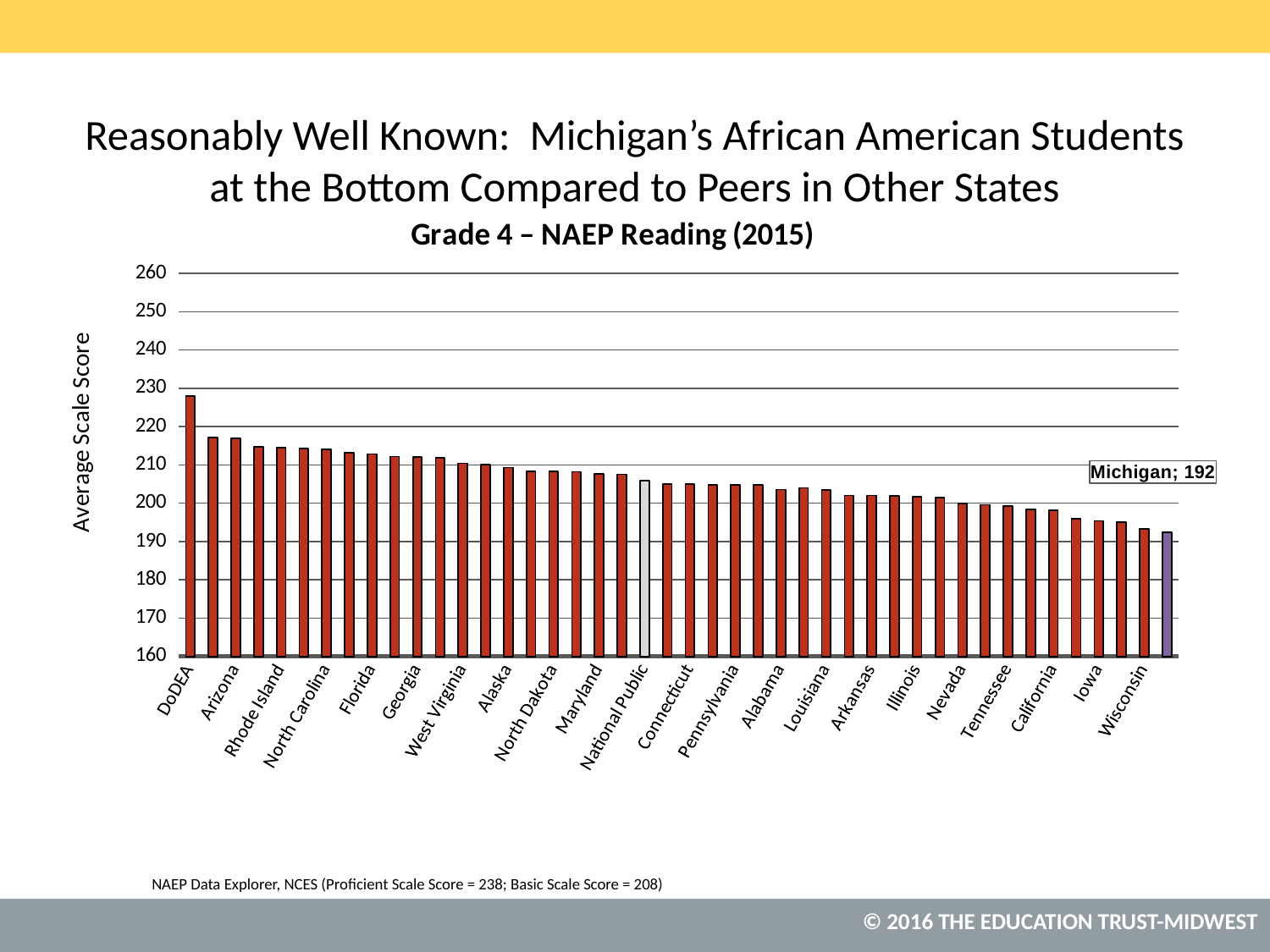
Is the value for Florida greater or less than 210? greater Is the value for Iowa greater or less than 200? less Is the value for Wisconsin greater or less than 200? less Which category has the lowest average scale score? Michigan Which category has the highest average scale score? DoDEA Which has a higher average scale score, Florida or Wisconsin? Florida Which has a higher average scale score, DoDEA or Arizona? DoDEA What is the average scale score shown for Michigan? 192 Do the values rise or fall moving from left to right along the x axis? Fall What is the title of the y axis? Average Scale Score What kind of chart is shown on the slide? Bar chart